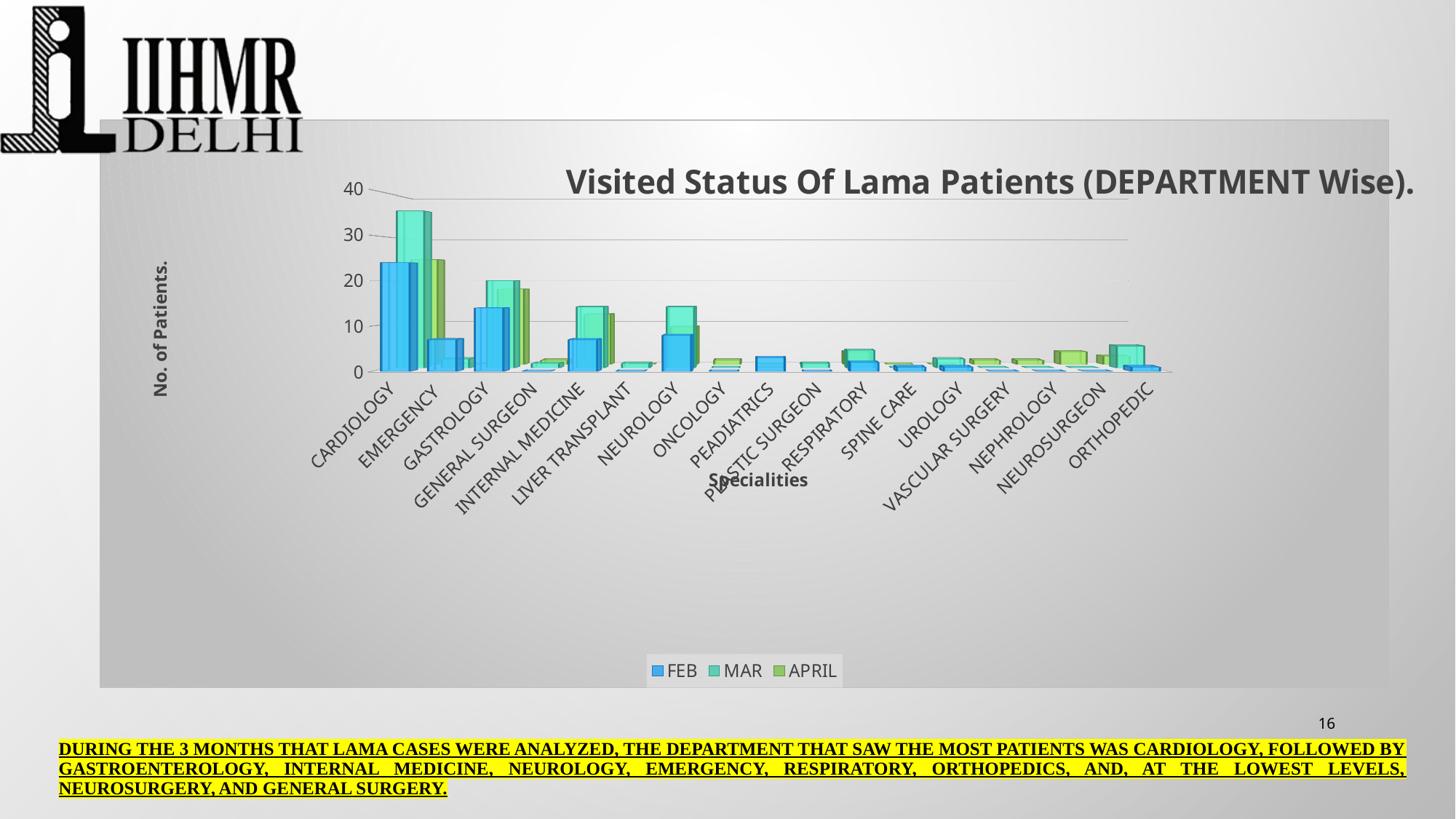
Is the MAR value for NEUROLOGY greater or less than 10? greater Is the MAR value for CARDIOLOGY greater or less than 30? greater Which speciality has the highest MAR value? CARDIOLOGY What kind of chart is shown on the slide? Bar chart What is the title of the chart? Visited Status Of Lama Patients (DEPARTMENT Wise). How many specialities (categories) are shown on the x axis? 17 For EMERGENCY, which is larger: the FEB value or the MAR value? FEB Is the FEB value for EMERGENCY greater or less than 10? less How many series does the legend list? 3 For CARDIOLOGY, which is larger: the FEB value or the MAR value? MAR Which speciality has the highest FEB value? CARDIOLOGY